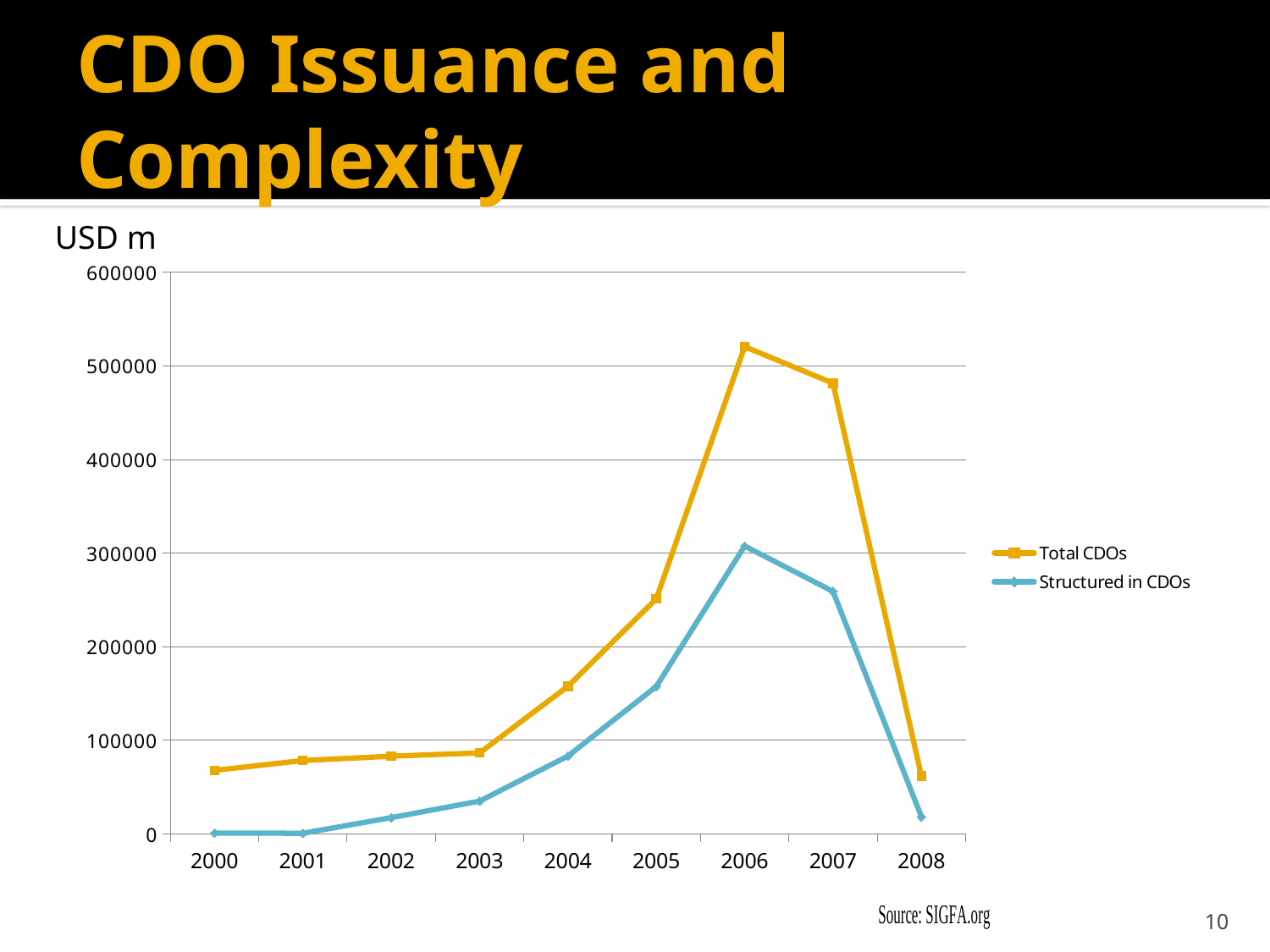
Is the value for Structured in CDOs in 2007 greater or less than 300000? less What kind of chart is shown on the slide? line chart Is the value for Total CDOs in 2006 greater or less than 500000? greater Do the Total CDOs values rise or fall from 2000 to 2006? rise How many years are plotted along the x axis? 9 In which year does the Total CDOs series reach its highest value? 2006 Is the value for Total CDOs in 2007 greater or less than 500000? less How many series does the legend list? 2 Which series has the larger value in 2006, Total CDOs or Structured in CDOs? Total CDOs In which year does the Structured in CDOs series reach its highest value? 2006